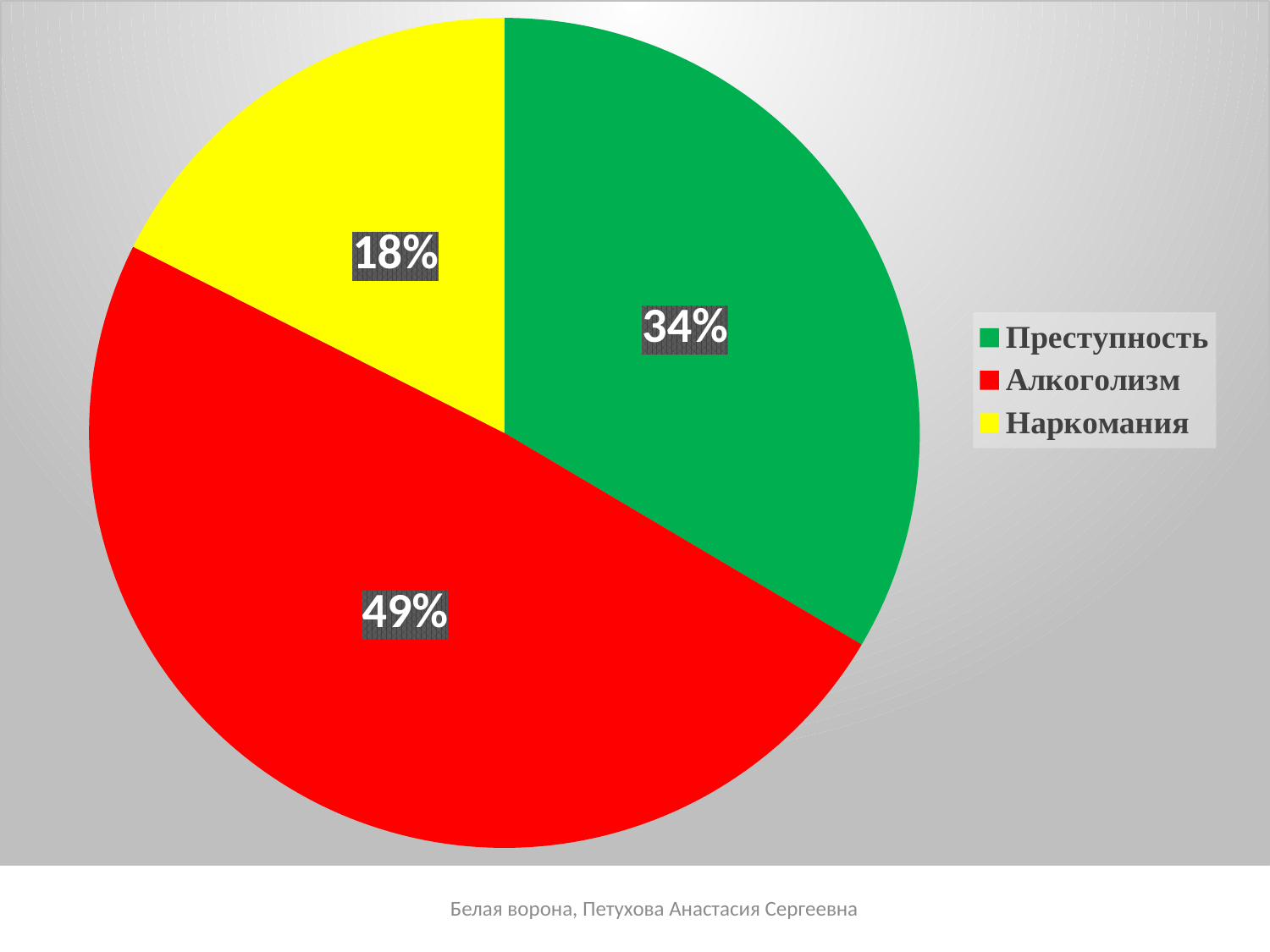
Which category has the smallest share of the pie? Наркомания What is the difference in percentage points between Алкоголизм and Преступность? 15 What type of chart is shown on the slide? pie chart What percentage is shown for Преступность? 34% Which category has the largest share of the pie? Алкоголизм Which is larger, the share for Преступность or the share for Наркомания? Преступность Which category is represented by the red slice? Алкоголизм What percentage is shown for Наркомания? 18% What percentage is shown for Алкоголизм? 49% How many entries does the legend list? 3 How many slices does the pie chart have? 3 What colour is the slice for Наркомания? yellow